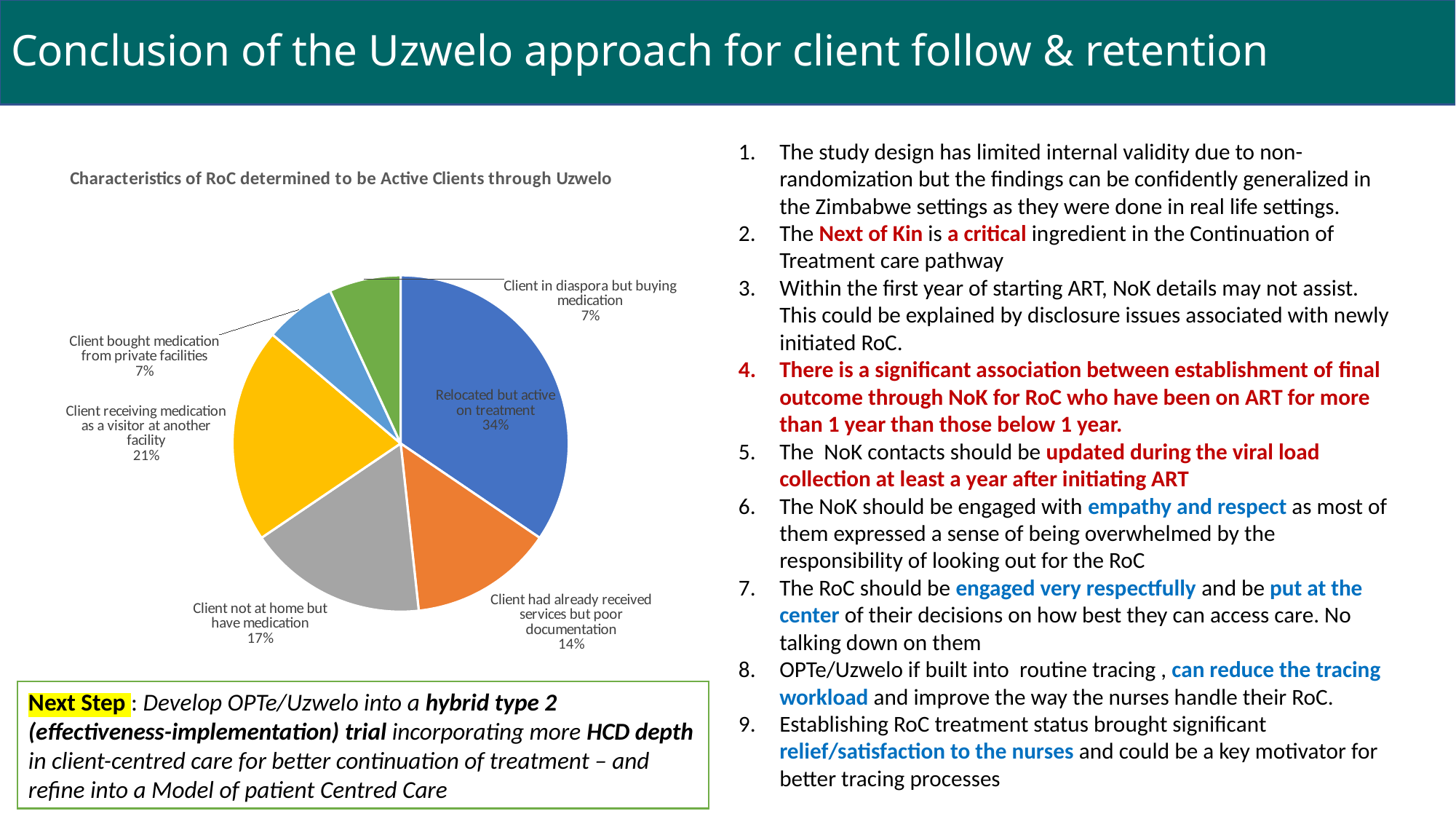
What percentage is shown for 'Client had already received services but poor documentation'? 14% What percentage is shown for 'Client in diaspora but buying medication'? 7% What type of chart is shown on the slide? Pie chart What percentage is shown for 'Client not at home but have medication'? 17% What colour is the 'Relocated but active on treatment' slice? Blue Which is larger: 'Client receiving medication as a visitor at another facility' or 'Client had already received services but poor documentation'? Client receiving medication as a visitor at another facility What is the difference in percentage points between 'Relocated but active on treatment' and 'Client not at home but have medication'? 17 Which category has the largest slice of the pie? Relocated but active on treatment What is the title of the chart? Characteristics of RoC determined to be Active Clients through Uzwelo What share of the pie is 'Relocated but active on treatment'? 34% What percentage is shown for 'Client receiving medication as a visitor at another facility'? 21% How many slices does the pie chart have? 6